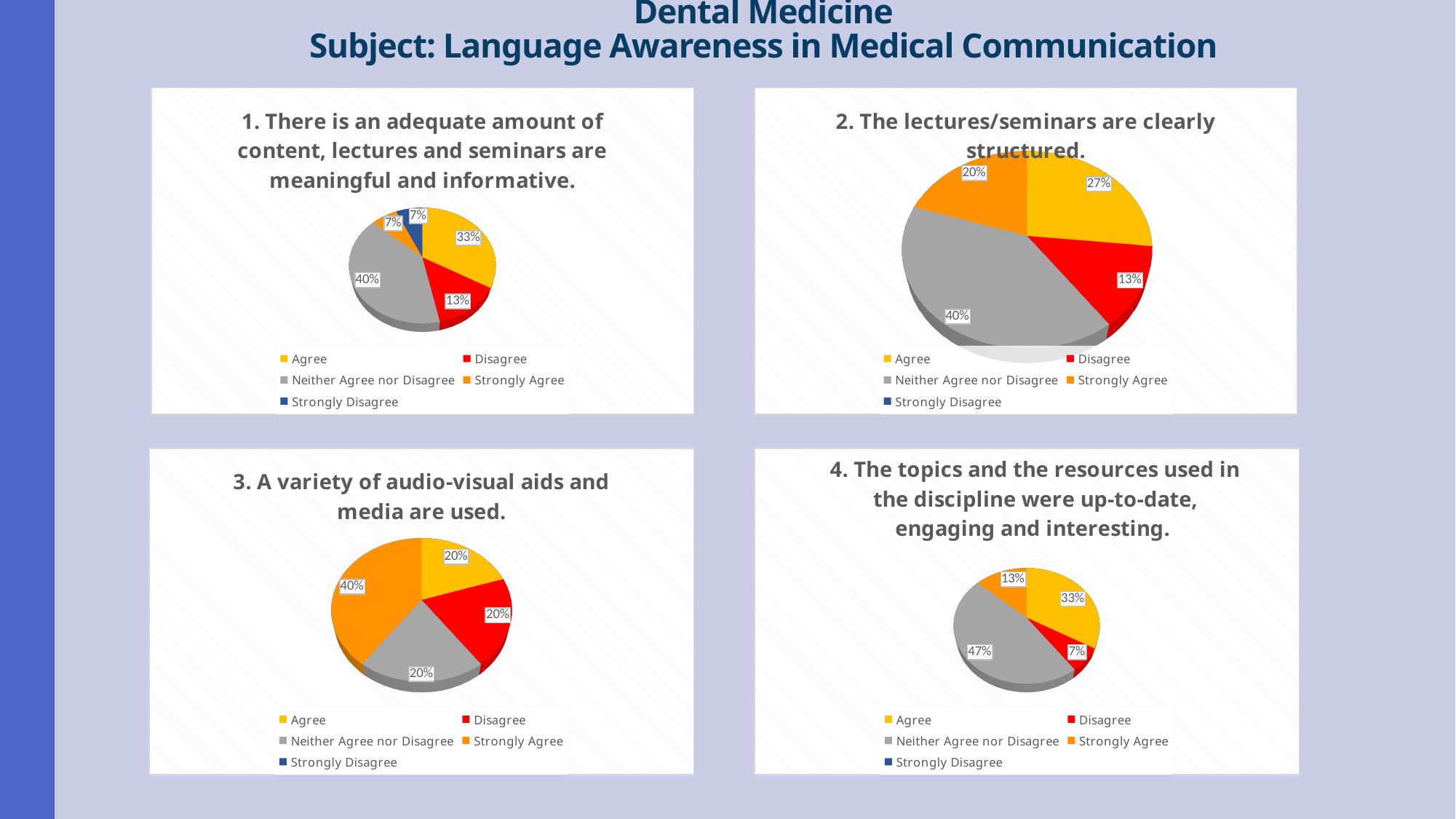
In the chart titled "1. There is an adequate amount of content, lectures and seminars are meaningful and informative.", what is the value for Strongly Disagree? 7% In the chart titled "4. The topics and the resources used in the discipline were up-to-date, engaging and interesting.", what is the value for Neither Agree nor Disagree? 47% In the chart titled "2. The lectures/seminars are clearly structured.", which category has the largest slice? Neither Agree nor Disagree What kind of chart is used in the bottom-left chart on the slide? Pie chart In the chart titled "1. There is an adequate amount of content, lectures and seminars are meaningful and informative.", what is the value for Agree? 33% In the chart titled "1. There is an adequate amount of content, lectures and seminars are meaningful and informative.", what share of the pie is Neither Agree nor Disagree? 40% In the chart titled "2. The lectures/seminars are clearly structured.", what is the difference between Agree and Disagree? 14% In the chart titled "3. A variety of audio-visual aids and media are used.", which category has the largest slice? Strongly Agree How many entries does the legend list in the chart titled "1. There is an adequate amount of content, lectures and seminars are meaningful and informative."? 5 In the chart titled "3. A variety of audio-visual aids and media are used.", what is the value for Disagree? 20% In the chart titled "4. The topics and the resources used in the discipline were up-to-date, engaging and interesting.", which is larger, Agree or Strongly Agree? Agree In the chart titled "2. The lectures/seminars are clearly structured.", what is the value for Strongly Agree? 20%